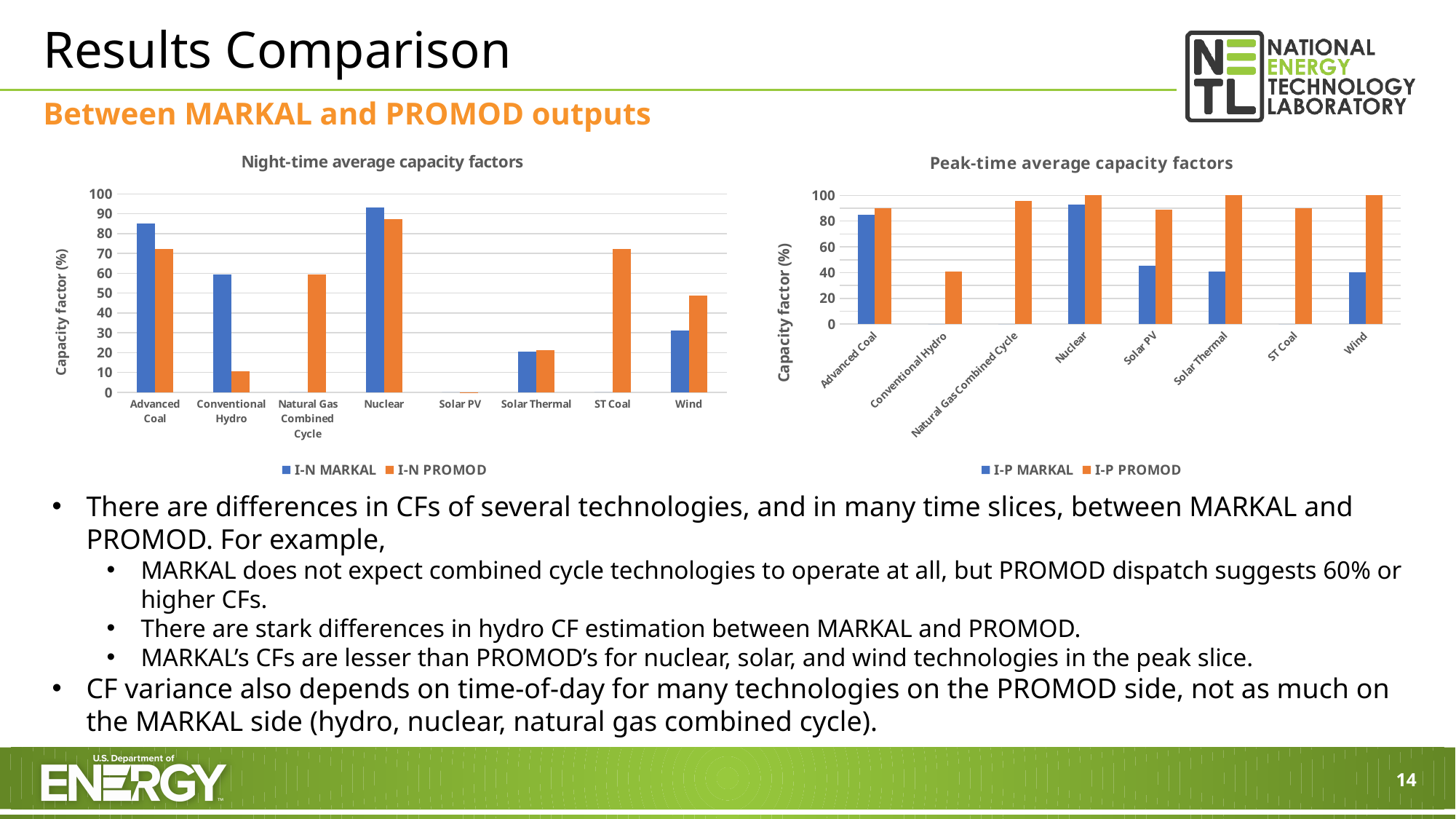
In the 'Peak-time average capacity factors' chart, what is the label of the y axis? Capacity factor (%) In the 'Night-time average capacity factors' chart, for Wind, which series has the larger value, I-N MARKAL or I-N PROMOD? I-N PROMOD In the 'Night-time average capacity factors' chart, which technology has the highest I-N MARKAL capacity factor? Nuclear In the 'Peak-time average capacity factors' chart, for Solar PV, which series has the larger value, I-P MARKAL or I-P PROMOD? I-P PROMOD In the 'Night-time average capacity factors' chart, how many technology categories are shown on the x axis? 8 In the 'Peak-time average capacity factors' chart, is the I-P PROMOD value for Conventional Hydro greater or less than 60? less In the 'Peak-time average capacity factors' chart, what are the two legend entries? I-P MARKAL and I-P PROMOD In the 'Night-time average capacity factors' chart, is the I-N MARKAL value for Conventional Hydro greater or less than 50? greater In the 'Night-time average capacity factors' chart, what kind of chart is used? bar chart In the 'Night-time average capacity factors' chart, how many series does the legend list? 2 In the 'Night-time average capacity factors' chart, is the I-N PROMOD value for Advanced Coal greater or less than 80? less In the 'Peak-time average capacity factors' chart, which technology has the highest I-P MARKAL capacity factor? Nuclear